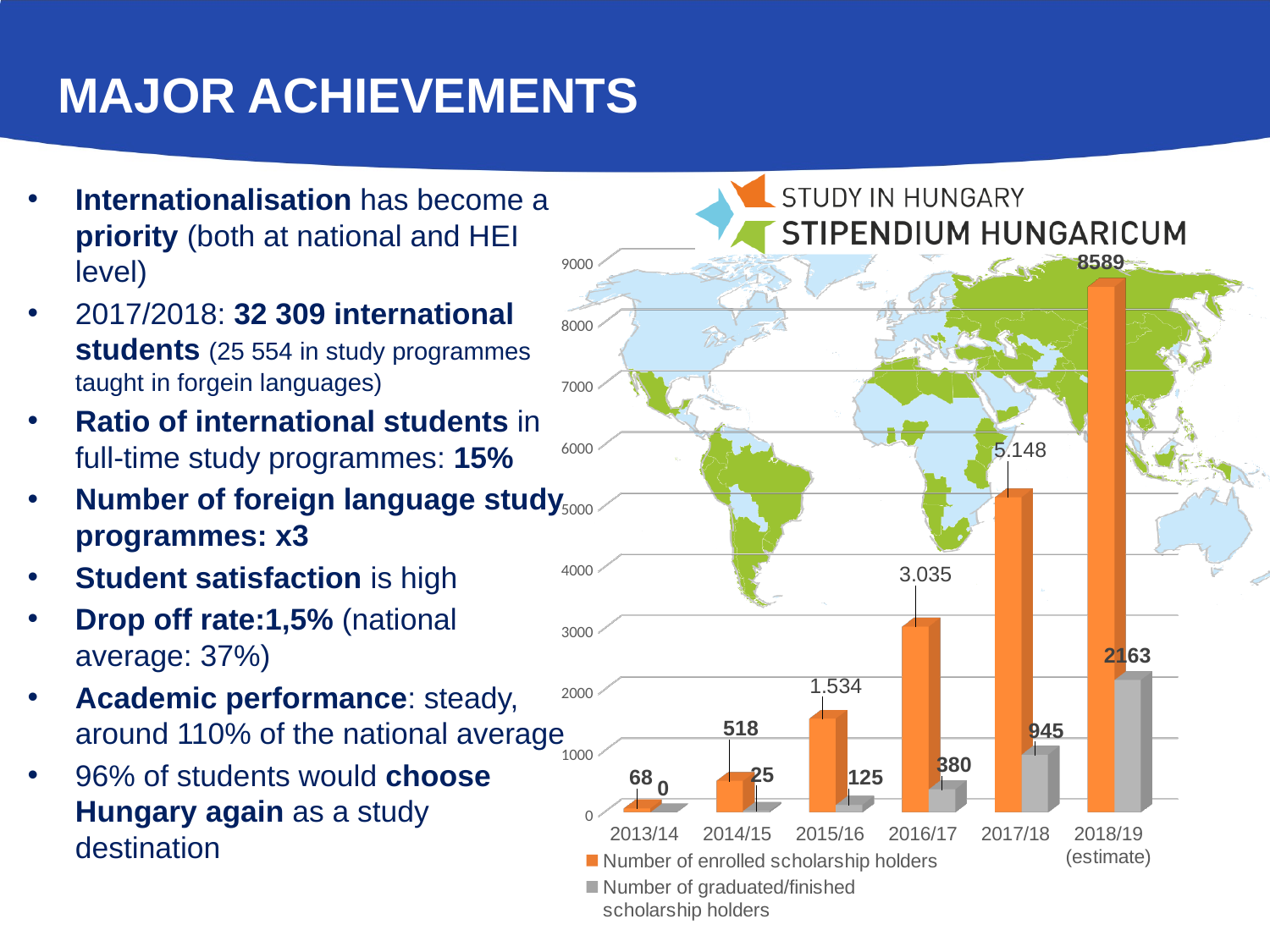
What is the number of graduated/finished scholarship holders in 2016/17? 380 Which year has the highest number of enrolled scholarship holders? 2018/19 (estimate) What is the estimated number of graduated/finished scholarship holders in 2018/19? 2163 How many series does the chart legend list? 2 How many years are shown on the x axis of the chart? 6 Which year has the lowest number of graduated/finished scholarship holders? 2013/14 What is the number of enrolled scholarship holders in 2014/15? 518 What kind of chart is shown on the slide? Bar chart Is the number of enrolled scholarship holders in 2016/17 greater or less than 2000? greater Which is larger: the number of enrolled scholarship holders in 2014/15 or the number of graduated/finished scholarship holders in 2017/18? Number of graduated/finished scholarship holders in 2017/18 What is the difference between the number of graduated/finished scholarship holders in 2017/18 and in 2016/17? 565 What is the number of enrolled scholarship holders in 2017/18? 5.148